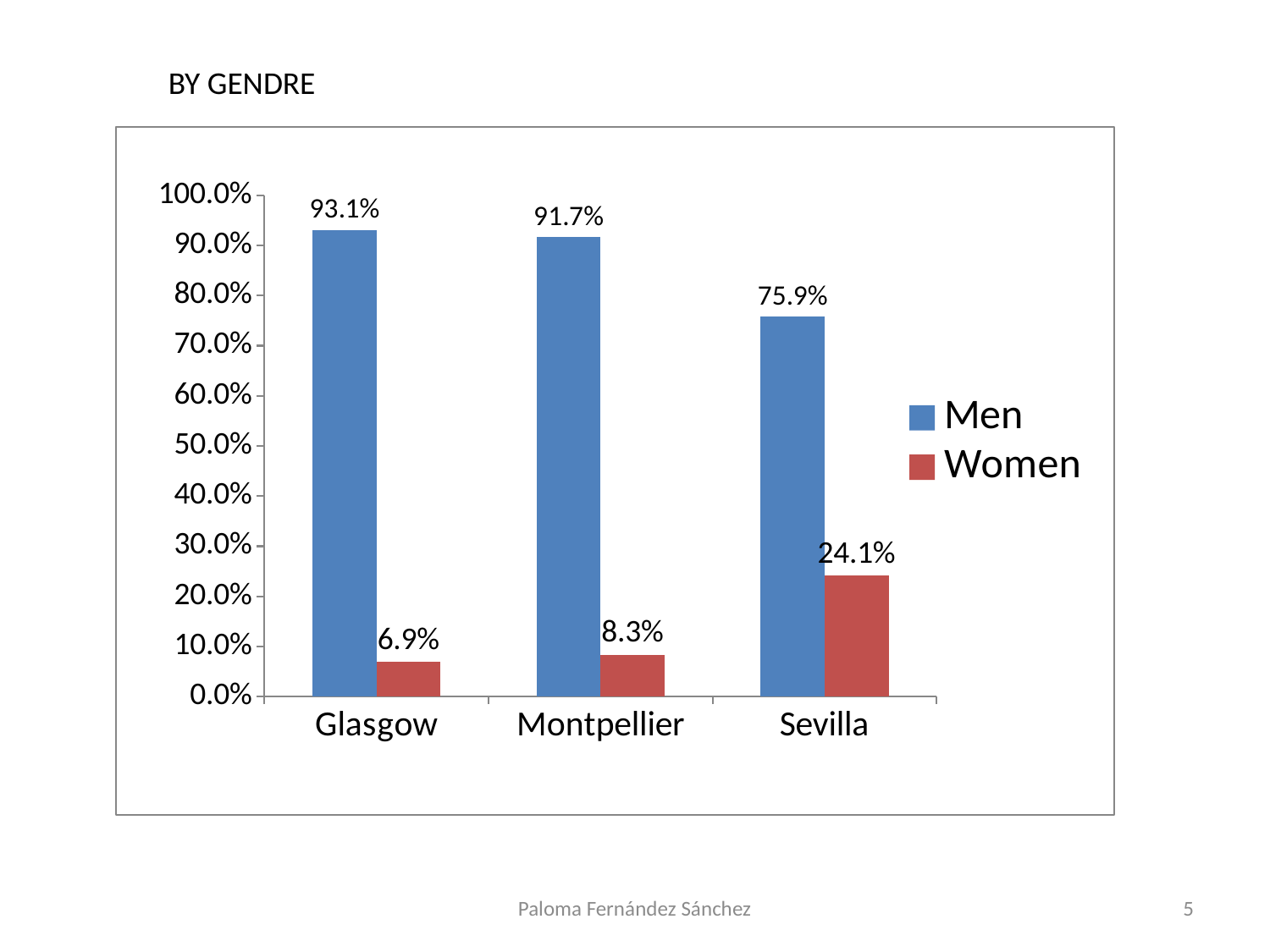
What is the value for Men in Glasgow? 93.1% What is the value for Women in Montpellier? 8.3% What is the value for Women in Sevilla? 24.1% What is the difference between the Men and Women values in Sevilla? 51.8% What kind of chart is shown on the slide? bar chart Which city has the highest value for Men? Glasgow Is the value for Men in Sevilla greater or less than 80.0%? less Which is larger, the Women value in Montpellier or the Women value in Sevilla? Sevilla How many cities are shown on the x axis? 3 Which city has the lowest value for Women? Glasgow How many series does the legend list? 2 Which colour represents Women in the chart? red